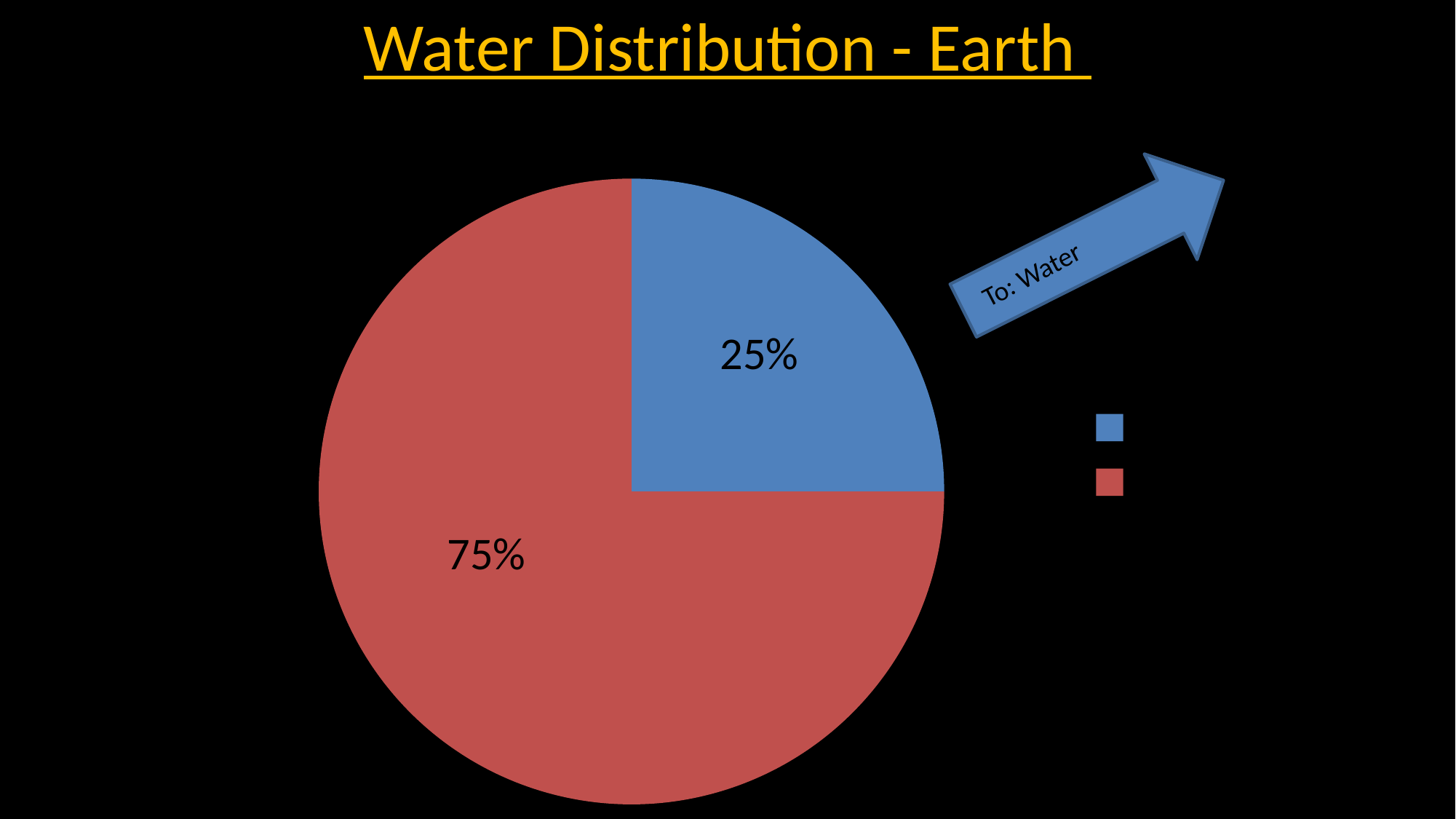
What is the title of the chart? Water Distribution - Earth What share of the pie does the blue slice represent? 25% What is the difference in percentage points between the red slice and the blue slice? 50 What percentage is shown on the blue slice of the pie chart? 25% Which is larger, the blue slice or the red slice? the red slice What text is written on the arrow pointing away from the blue slice? To: Water How many slices does the pie chart have? 2 What kind of chart is shown on the slide? pie chart Which slice of the pie chart is the largest? the red slice (75%) How many colour swatches does the legend show? 2 Which slice of the pie chart is the smallest? the blue slice (25%) What percentage is shown on the red slice of the pie chart? 75%